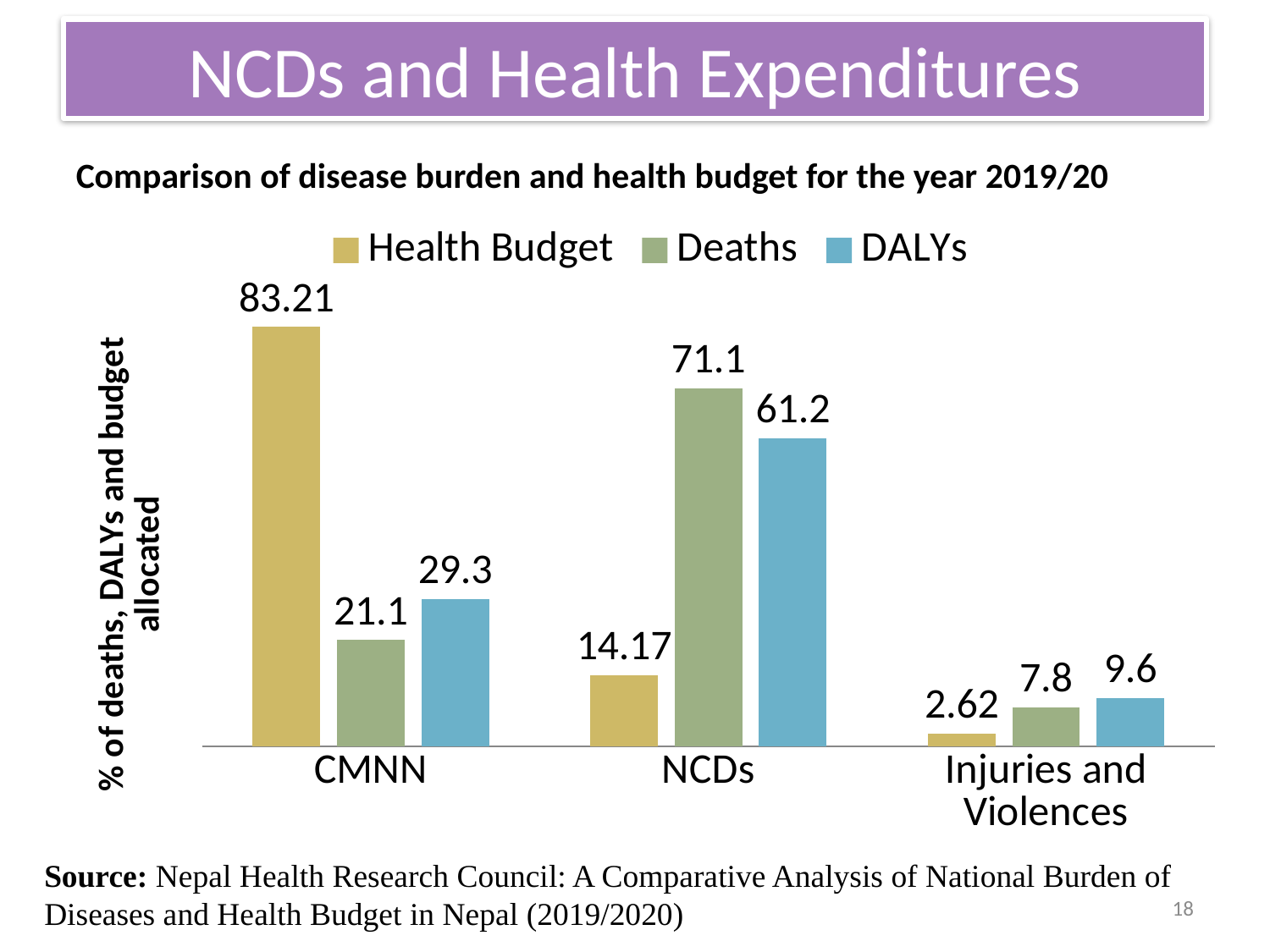
Which is larger for CMNN, the Deaths value or the DALYs value? DALYs What is the title of the chart? Comparison of disease burden and health budget for the year 2019/20 Which category has the lowest Health Budget value? Injuries and Violences What is the difference between the Deaths value and the Health Budget value for NCDs? 56.93 How many categories are shown on the x axis? 3 What is the Deaths value for NCDs? 71.1 What is the DALYs value for Injuries and Violences? 9.6 How many series does the legend list? 3 What kind of chart is shown on the slide? Bar chart What is the Health Budget value for NCDs? 14.17 What is the Health Budget value for CMNN? 83.21 Which category has the highest Deaths value? NCDs